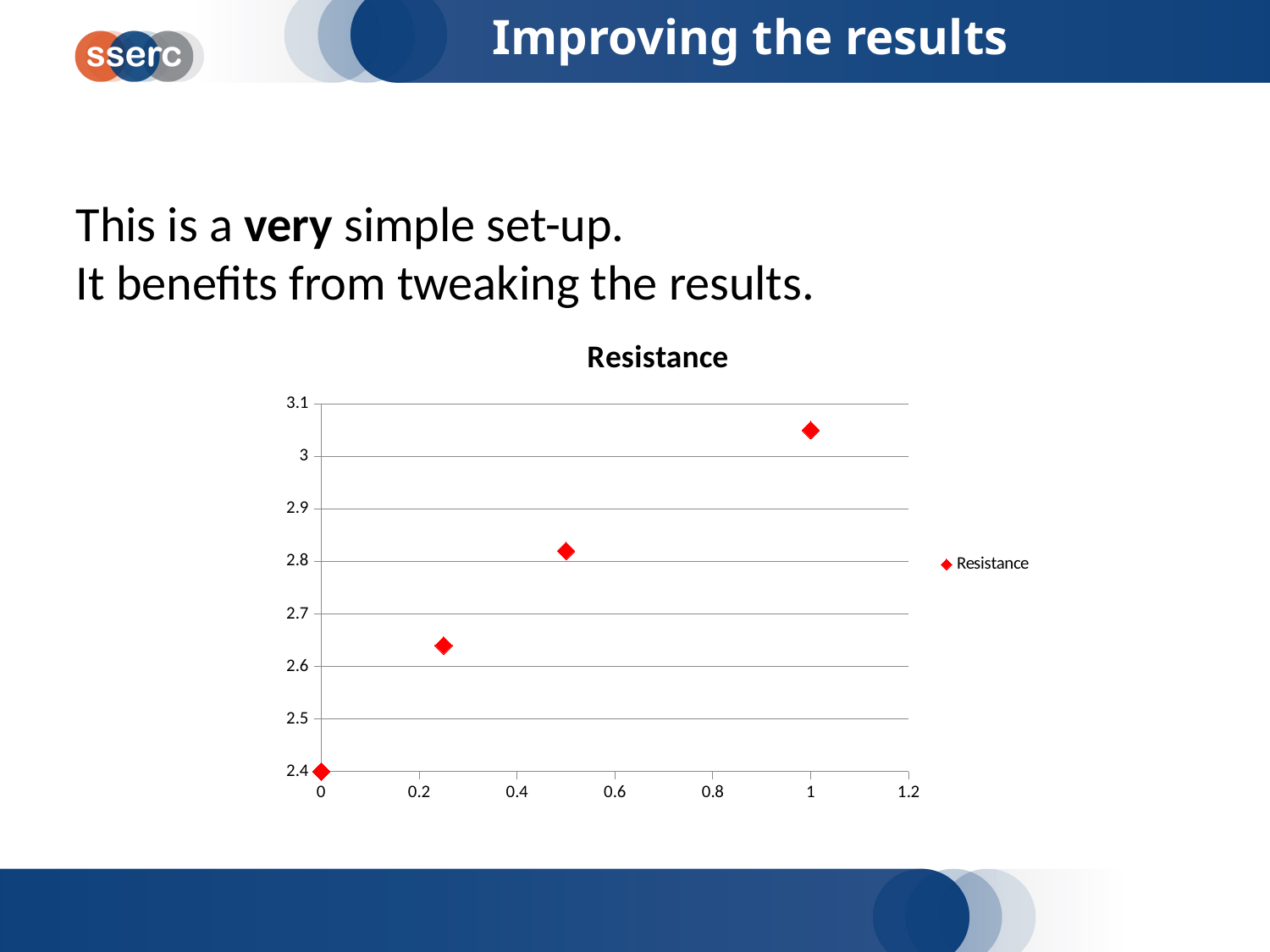
What is the title of the chart? Resistance How many series does the legend list? 1 What kind of chart is shown on the slide? scatter chart At which x value is the Resistance lowest? 0 Is the Resistance value at x = 0.5 greater or less than 2.7? greater Is the Resistance value at x = 1 greater or less than 3? greater What is the Resistance value at x = 0? 2.4 Do the Resistance values rise or fall as x increases? rise At which x value is the Resistance highest? 1 How many data points are plotted on the chart? 4 Which is larger, the Resistance at x = 0.5 or at x = 1? x = 1